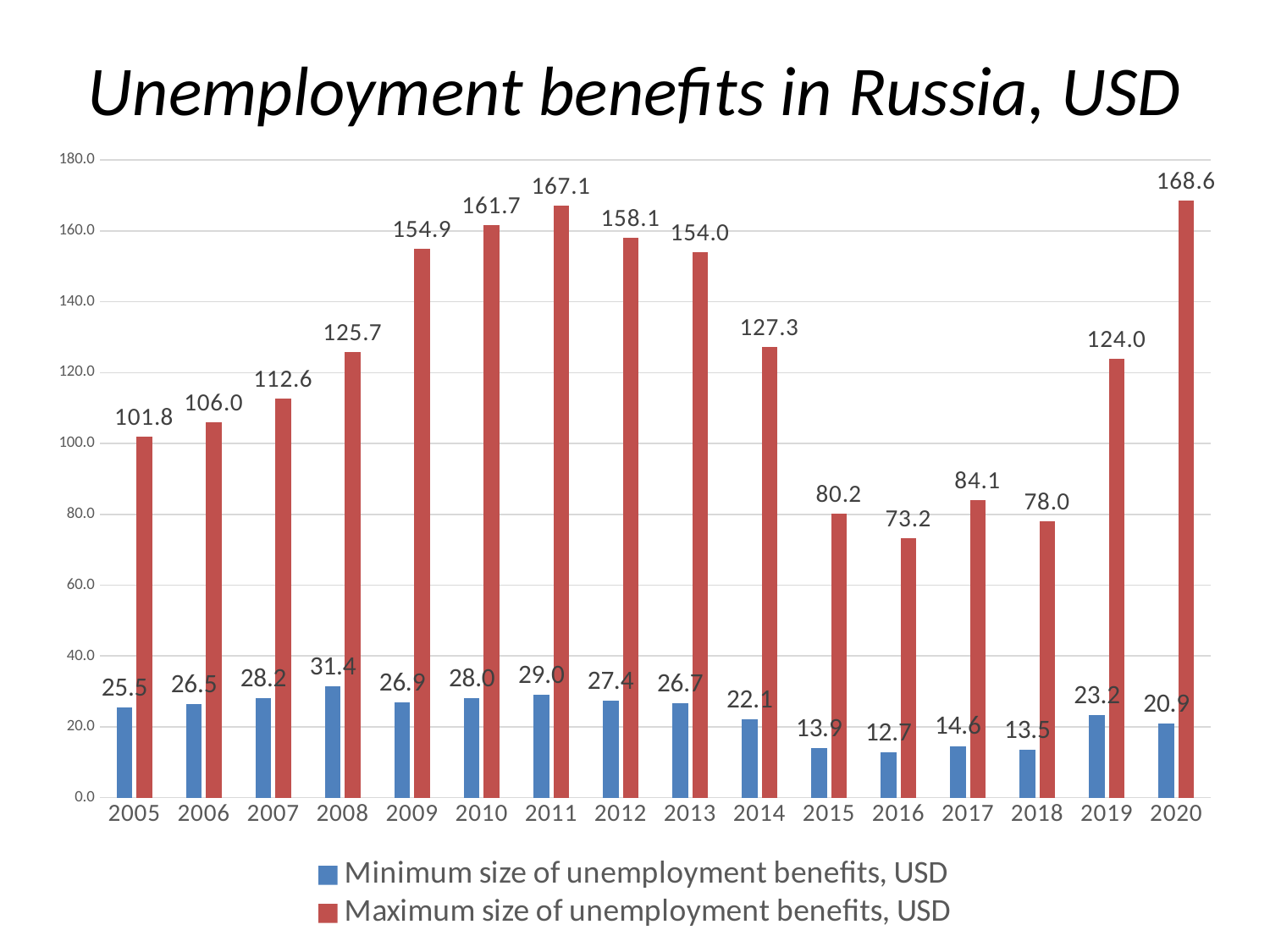
Which is larger: the maximum size of unemployment benefits in 2009 or in 2013? 2009 Which year has the lowest minimum size of unemployment benefits? 2016 What is the minimum size of unemployment benefits in 2016? 12.7 How many series does the legend list? 2 Which year has the highest maximum size of unemployment benefits? 2020 How many years are shown on the x axis? 16 What is the title of the chart? Unemployment benefits in Russia, USD What kind of chart is shown on the slide? Bar chart What is the difference between the maximum and minimum size of unemployment benefits in 2020? 147.7 Is the maximum size of unemployment benefits in 2014 greater or less than 120.0? greater Does the maximum size of unemployment benefits rise or fall from 2005 to 2011? Rise What is the maximum size of unemployment benefits in 2011? 167.1